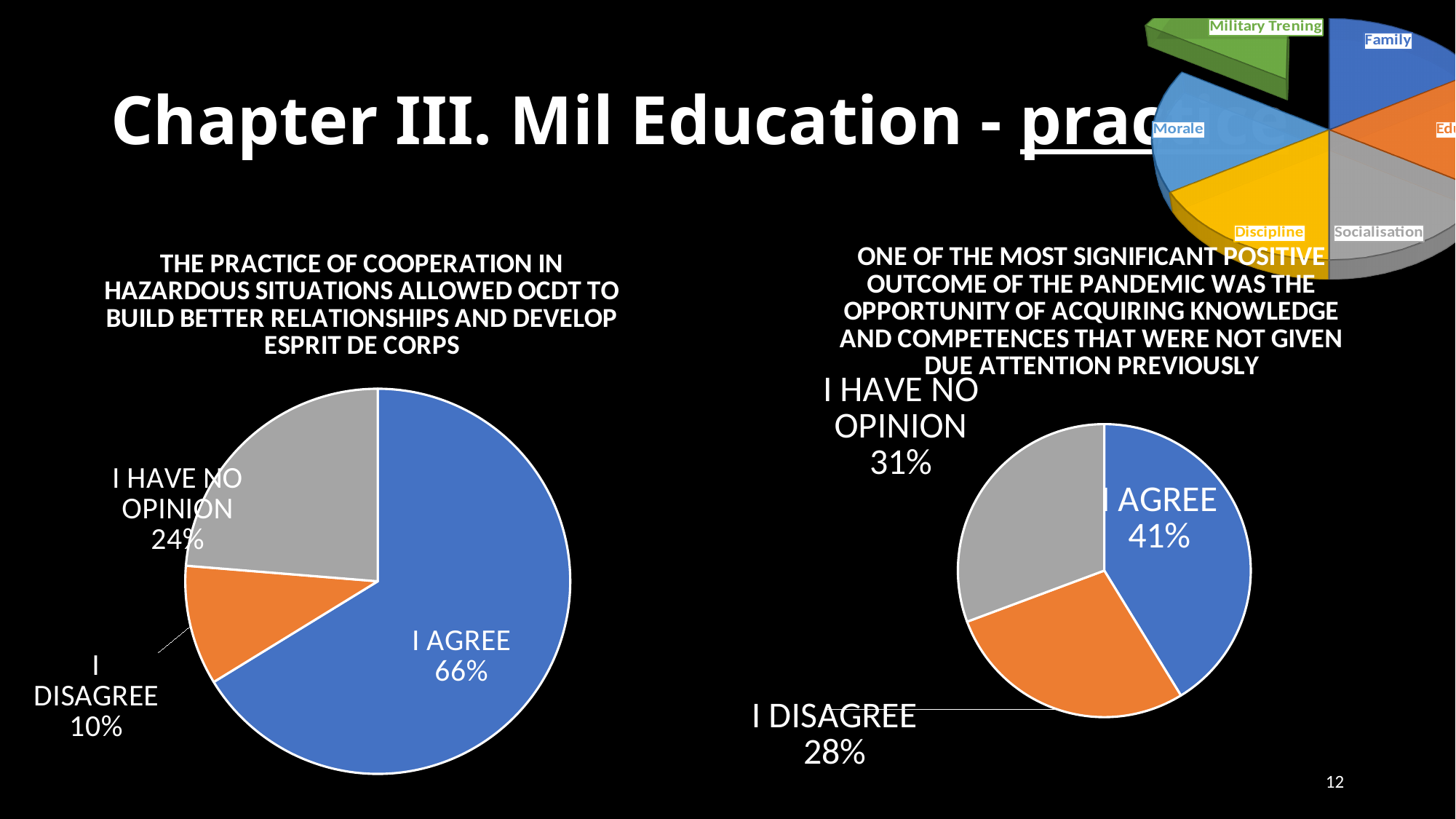
In the right pie chart, which response has the smallest share? I DISAGREE In the right pie chart, what share of respondents chose I DISAGREE? 28% In the right pie chart, what share of respondents chose I HAVE NO OPINION? 31% How many slices does the right pie chart have? 3 In the left pie chart, what share of respondents chose I DISAGREE? 10% In the right pie chart, which is larger: the I HAVE NO OPINION share or the I DISAGREE share? I HAVE NO OPINION In the left pie chart, which response has the largest share? I AGREE What type of chart is the left chart on the slide? Pie chart In the left pie chart, what share of respondents chose I HAVE NO OPINION? 24% In the right pie chart, what share of respondents chose I AGREE? 41% In the left pie chart, what share of respondents chose I AGREE? 66% In the left pie chart, what is the difference between the I AGREE share and the I HAVE NO OPINION share? 42%